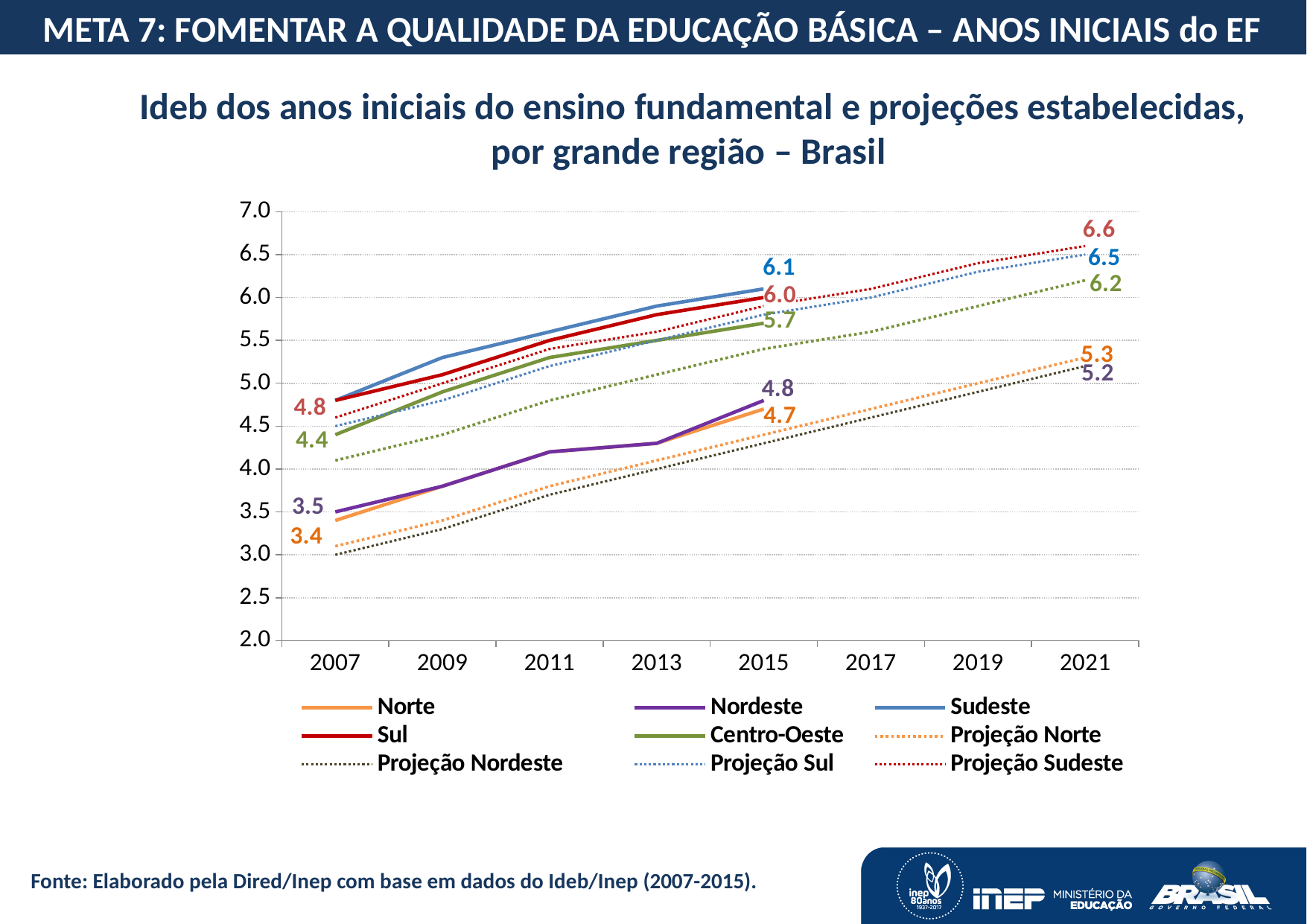
Which region has the lowest Ideb value in 2007? Norte What is the projected value for Projeção Norte in 2021? 5.3 By how much did the Centro-Oeste Ideb value increase from 2007 (4.4) to 2015 (5.7)? 1.3 How many series does the legend list? 9 What is the Ideb value for Sudeste in 2015? 6.1 What is the Ideb value for Norte in 2007? 3.4 What kind of chart is shown on the slide? line chart In 2015, which is higher: the value for Nordeste or the value for Norte? Nordeste What is the Ideb value for Centro-Oeste in 2015? 5.7 Which region has the highest Ideb value in 2015? Sudeste What is the projected value for Projeção Sudeste in 2021? 6.6 Does the Norte line rise or fall from 2007 to 2015? rise